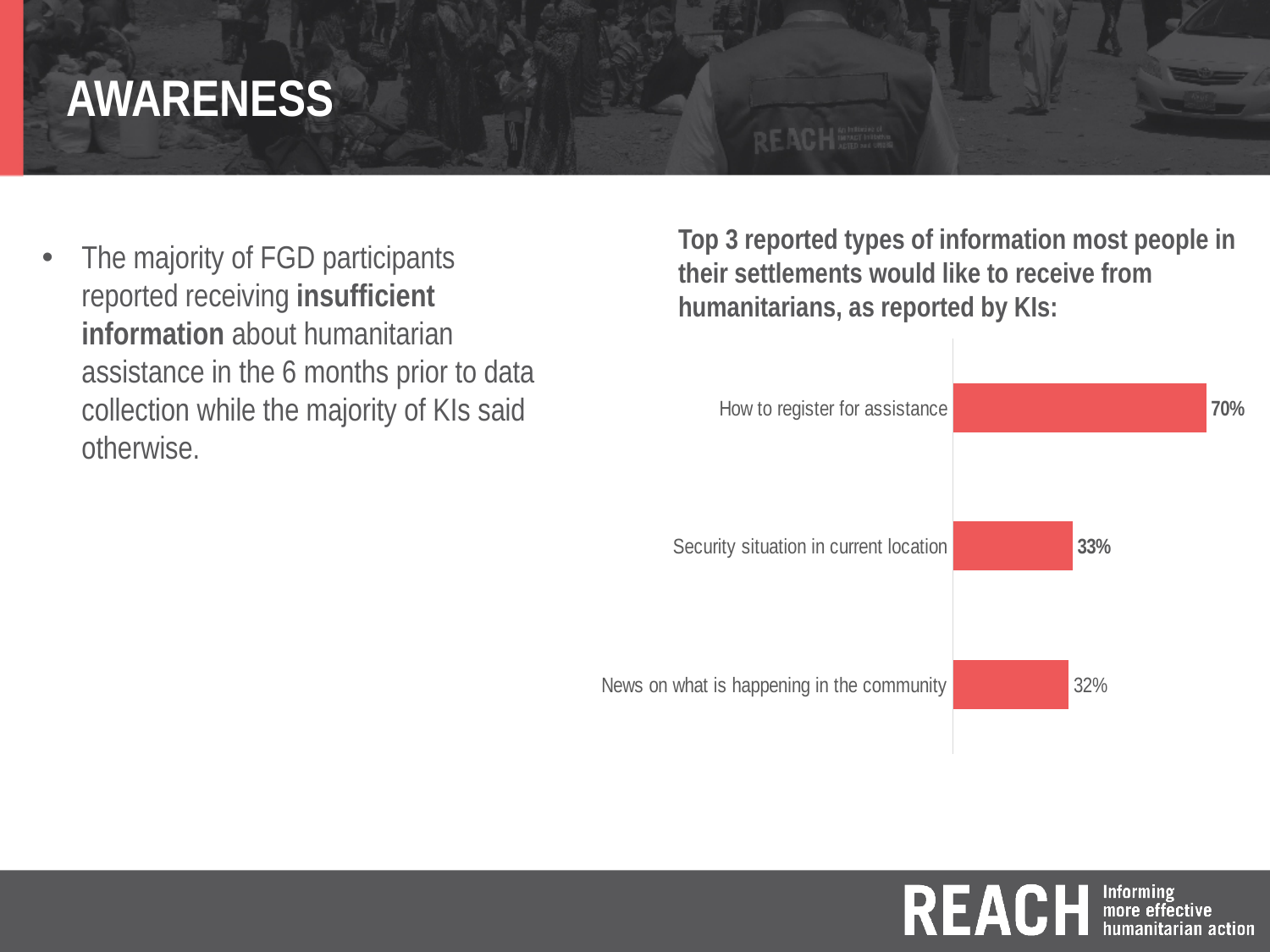
What kind of chart is used to show the top 3 reported types of information? Bar chart Which type of information has the lowest reported percentage? News on what is happening in the community What is the difference in percentage points between 'Security situation in current location' and 'News on what is happening in the community'? 1 What percentage of KIs reported 'How to register for assistance' as a type of information people would like to receive? 70% What is the difference in percentage points between 'How to register for assistance' and 'Security situation in current location'? 37 What colour are the bars in the chart? Red What is the value shown for 'Security situation in current location'? 33% According to the chart title, who reported the top 3 types of information? KIs What is the value shown for 'News on what is happening in the community'? 32% Which has a larger value: 'How to register for assistance' or 'News on what is happening in the community'? How to register for assistance How many types of information are shown in the chart? 3 Which type of information has the highest reported percentage? How to register for assistance